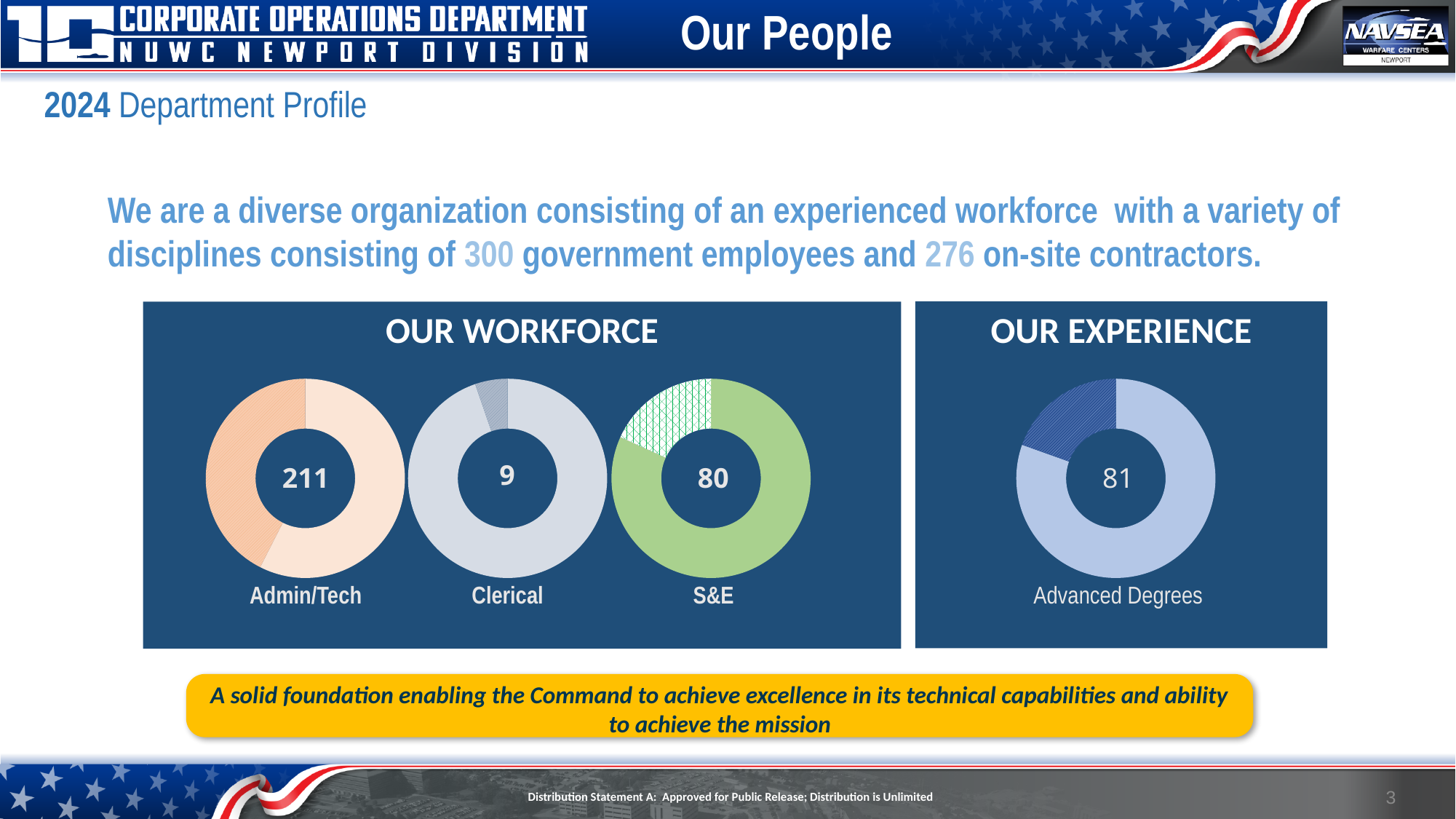
In the OUR WORKFORCE panel, what number is shown in the center of the Clerical donut chart? 9 What are the titles of the two dark blue panels containing the charts? OUR WORKFORCE and OUR EXPERIENCE In the OUR WORKFORCE panel, what number is shown in the center of the Admin/Tech donut chart? 211 What type of chart is used to show the Advanced Degrees figure in the OUR EXPERIENCE panel? Donut chart In the OUR EXPERIENCE panel, what number is shown in the center of the Advanced Degrees donut chart? 81 In the OUR WORKFORCE panel, which category has the lowest number shown? Clerical In the OUR WORKFORCE panel, what number is shown in the center of the S&E donut chart? 80 How many donut charts are shown in the OUR WORKFORCE panel? 3 In the OUR WORKFORCE panel, which category has the highest number shown? Admin/Tech Comparing the S&E donut in the OUR WORKFORCE panel with the Advanced Degrees donut in the OUR EXPERIENCE panel, which shows the larger number? Advanced Degrees In the OUR WORKFORCE panel, what is the difference between the S&E number and the Clerical number? 71 In the OUR WORKFORCE panel, what is the difference between the Admin/Tech number and the S&E number? 131